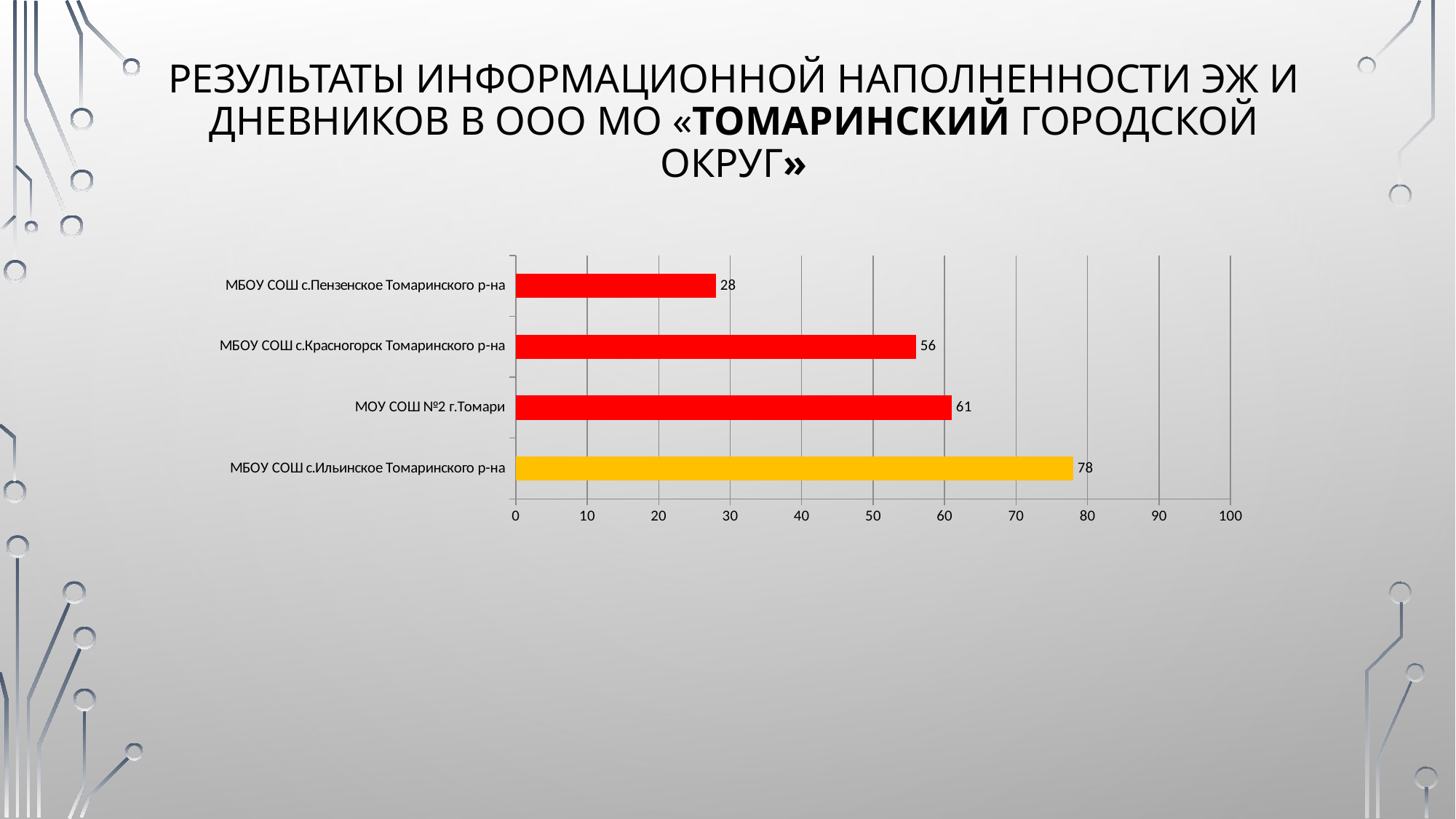
What is the difference between the values for МОУ СОШ №2 г.Томари and МБОУ СОШ с.Красногорск Томаринского р-на? 5 What is the value for МБОУ СОШ с.Красногорск Томаринского р-на? 56 Which bar is coloured yellow rather than red? МБОУ СОШ с.Ильинское Томаринского р-на What is the difference between the values for МБОУ СОШ с.Ильинское Томаринского р-на and МБОУ СОШ с.Пензенское Томаринского р-на? 50 Which school has the highest value? МБОУ СОШ с.Ильинское Томаринского р-на Which school has the lowest value? МБОУ СОШ с.Пензенское Томаринского р-на What kind of chart is shown on the slide? bar chart What is the value for МБОУ СОШ с.Пензенское Томаринского р-на? 28 What is the value for МОУ СОШ №2 г.Томари? 61 How many schools are shown in the chart? 4 What is the value for МБОУ СОШ с.Ильинское Томаринского р-на? 78 Which has a larger value, МБОУ СОШ с.Красногорск Томаринского р-на or МБОУ СОШ с.Пензенское Томаринского р-на? МБОУ СОШ с.Красногорск Томаринского р-на